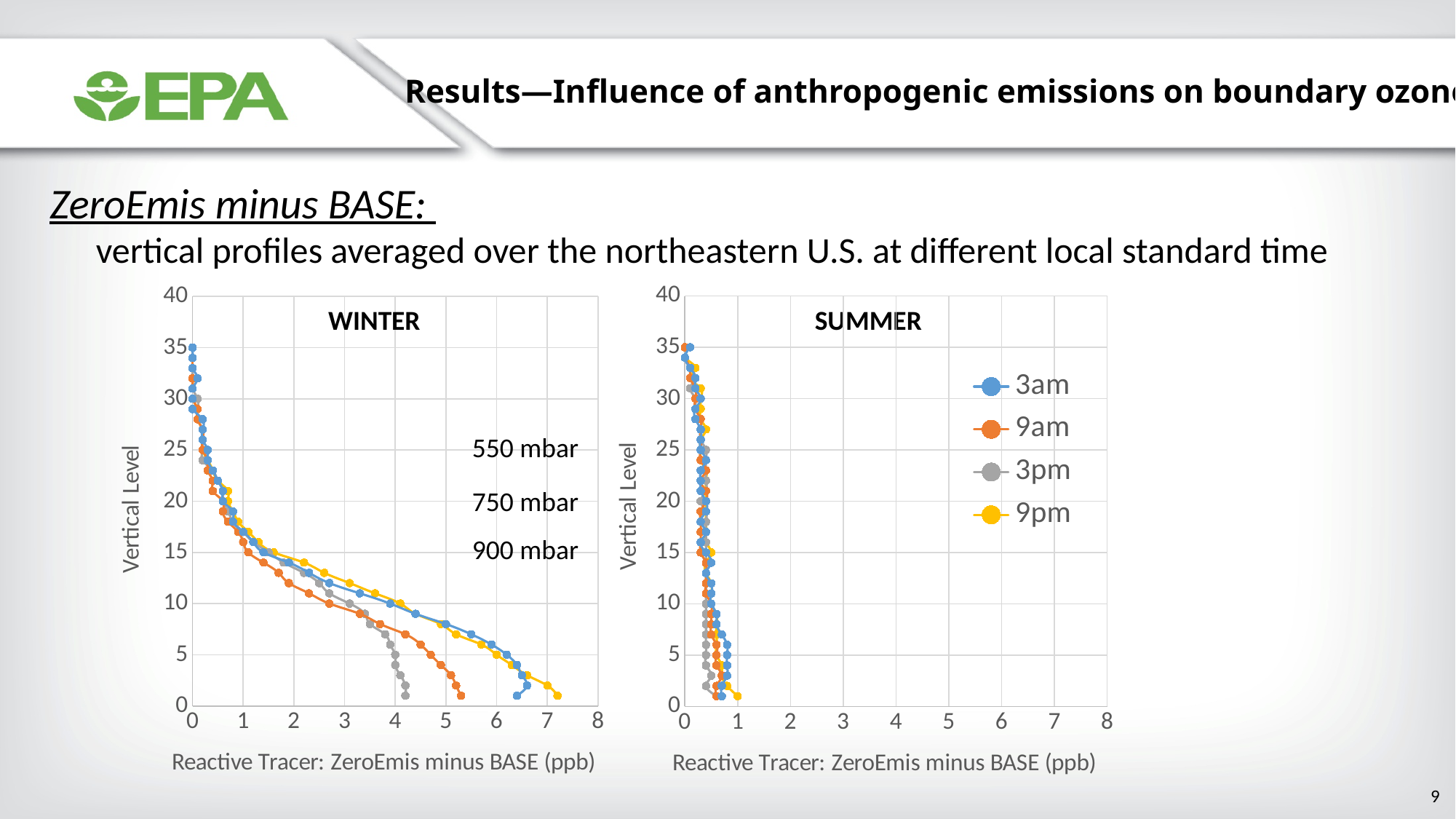
In the WINTER chart, is the 3am value at vertical level 1 greater or less than 6? greater In the WINTER chart, which series has the smallest value at vertical level 1? 3pm In the WINTER chart, which series has the largest value at vertical level 1? 9pm What is the x-axis label of the WINTER chart? Reactive Tracer: ZeroEmis minus BASE (ppb) What kind of chart is the WINTER chart? line chart In the SUMMER chart, is the 9pm value at vertical level 1 greater or less than 2? less In the WINTER chart, at vertical level 1, which is larger: the 9pm value or the 3pm value? 9pm In the WINTER chart, is the 3pm value at vertical level 1 greater or less than 5? less What are the series names listed in the legend? 3am, 9am, 3pm, 9pm How many series does the legend on the SUMMER chart list? 4 In the WINTER chart, do the tracer values increase or decrease as the vertical level rises from 1 to 35? decrease